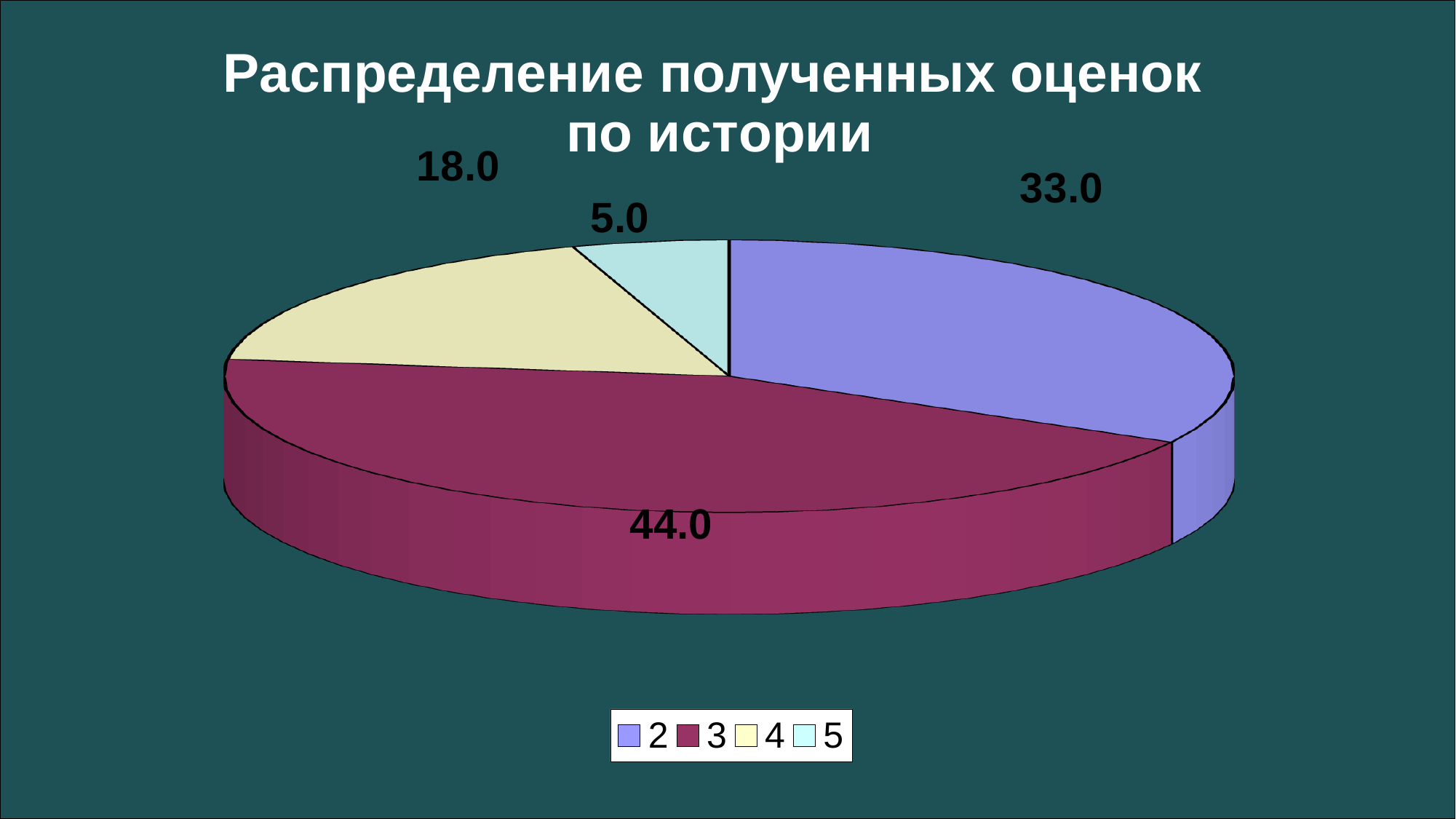
What is the value for grade 2 in the pie chart? 33.0 What is the value for grade 3 in the pie chart? 44.0 What type of chart is shown on the slide? pie chart Which is larger, the value for grade 4 or the value for grade 5? grade 4 What is the total of all the values shown in the pie chart? 100.0 Which grade has the largest slice of the pie? 3 What is the value for grade 5 in the pie chart? 5.0 What is the title of the chart? Распределение полученных оценок по истории What is the difference between the values for grade 3 and grade 2? 11.0 How many slices does the pie chart have? 4 Which grade has the smallest slice of the pie? 5 What is the value for grade 4 in the pie chart? 18.0